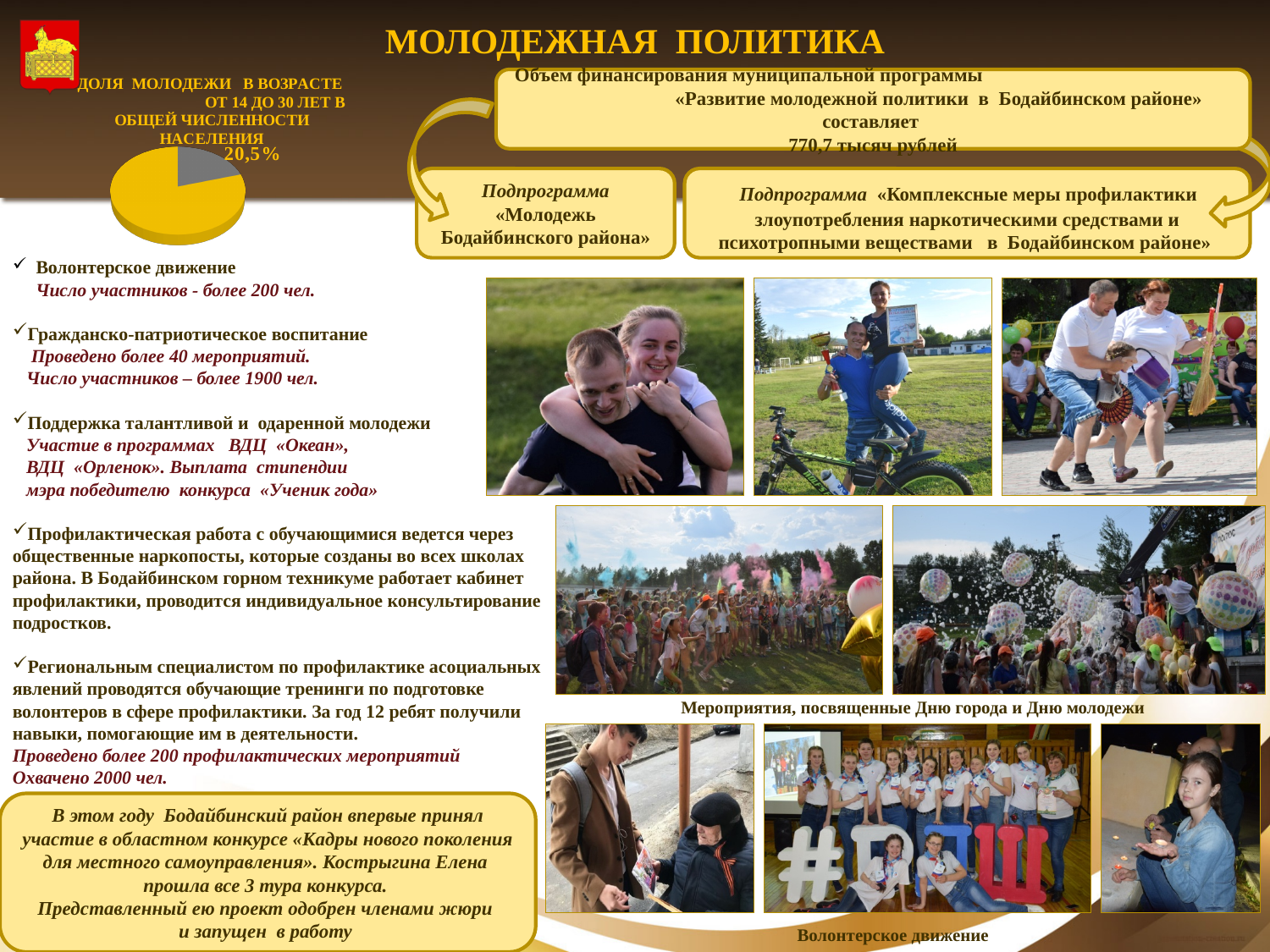
What kind of chart is shown under the heading "ДОЛЯ МОЛОДЕЖИ В ВОЗРАСТЕ ОТ 14 ДО 30 ЛЕТ В ОБЩЕЙ ЧИСЛЕННОСТИ НАСЕЛЕНИЯ"? Pie chart What is the title of the pie chart on the slide? ДОЛЯ МОЛОДЕЖИ В ВОЗРАСТЕ ОТ 14 ДО 30 ЛЕТ В ОБЩЕЙ ЧИСЛЕННОСТИ НАСЕЛЕНИЯ Which slice of the pie chart is larger: the grey slice (youth aged 14–30) or the yellow slice (the rest of the population)? The yellow slice (the rest of the population) What colour is the slice of the pie chart that represents youth aged 14 to 30 (labelled 20,5 %)? Grey What share of the total population is made up of young people aged 14 to 30, according to the pie chart? 20,5 % How many slices does the pie chart have? 2 Is the share of youth aged 14 to 30 shown in the pie chart more or less than half of the total population? Less What value is printed as the data label on the pie chart? 20,5 %